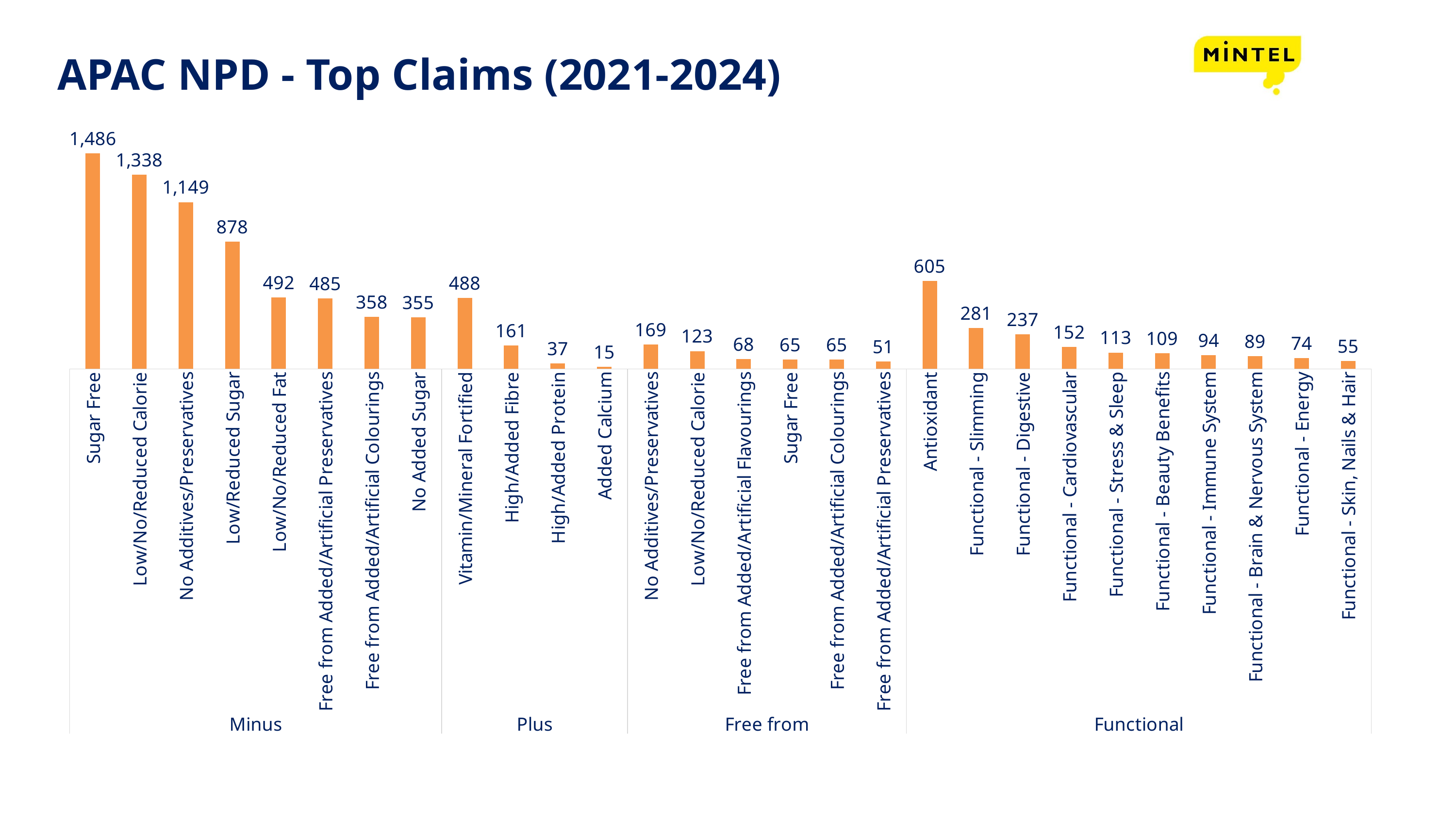
What is the value for Antioxidant in the Functional group? 605 How many bars are shown in the Functional group? 10 What is the value for Sugar Free in the Minus group? 1,486 Which claim has the highest value on the chart? Sugar Free (Minus) How many claim categories are plotted on the chart in total? 28 What is the value for Sugar Free in the Free from group? 65 What is the value for Vitamin/Mineral Fortified in the Plus group? 488 What is the difference between Low/No/Reduced Calorie in the Minus group and Low/Reduced Sugar? 460 Which claim has the lowest value on the chart? Added Calcium What is the title of the chart? APAC NPD - Top Claims (2021-2024) Which is larger: Functional - Slimming or Functional - Digestive? Functional - Slimming What kind of chart is shown on the slide? Bar chart